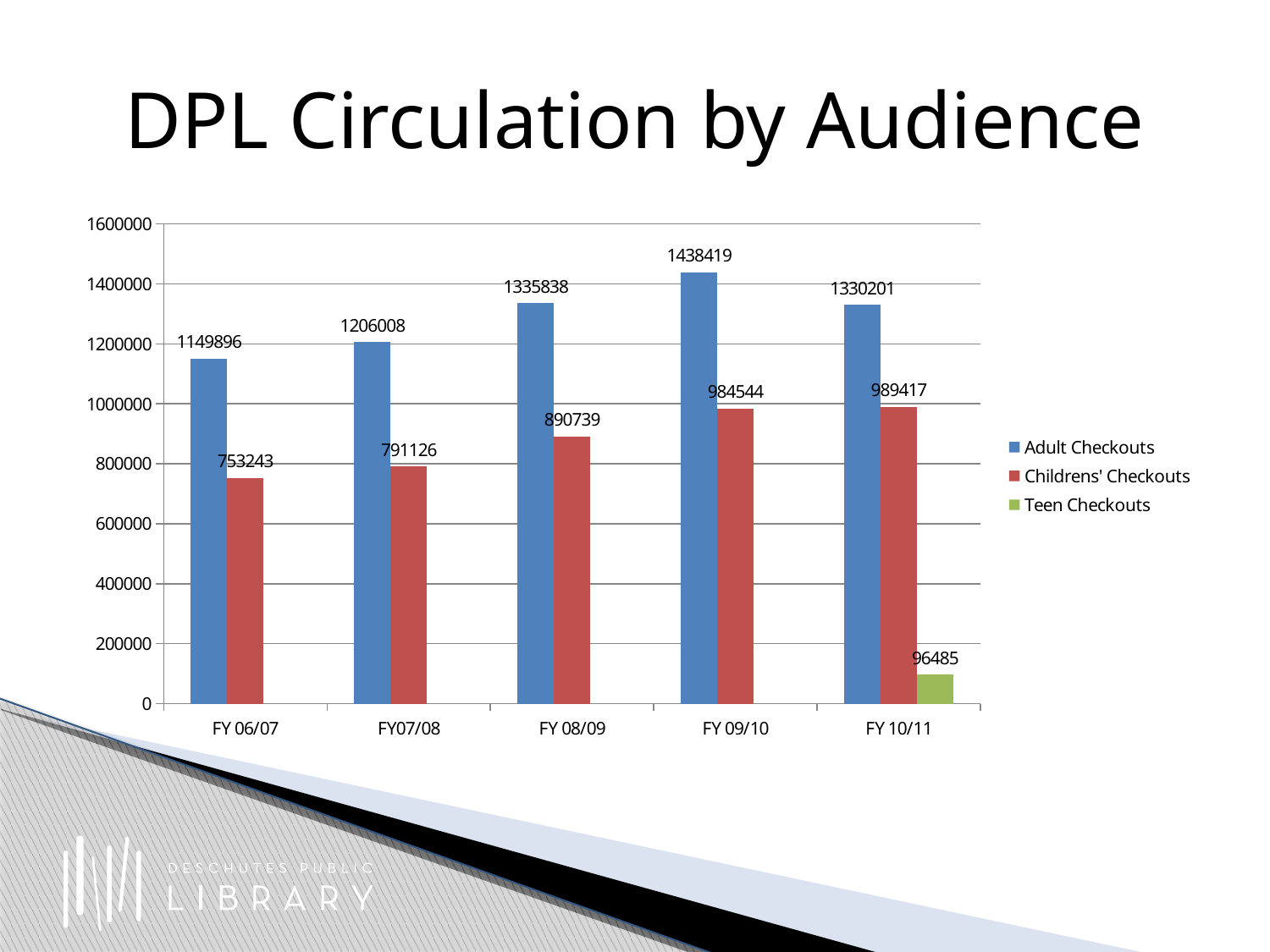
In which fiscal year are Childrens' Checkouts lowest? FY 06/07 How many series does the legend list? 3 What kind of chart is shown on the slide? bar chart What is the value for Childrens' Checkouts in FY 06/07? 753243 Which is larger: Adult Checkouts in FY 08/09 or Adult Checkouts in FY 10/11? Adult Checkouts in FY 08/09 In which fiscal year are Adult Checkouts highest? FY 09/10 What is the difference between Adult Checkouts and Childrens' Checkouts in FY 09/10? 453875 Is the value for Childrens' Checkouts in FY 10/11 greater or less than 1000000? less What is the value for Adult Checkouts in FY 09/10? 1438419 How many fiscal years are shown on the x axis? 5 What is the value for Teen Checkouts in FY 10/11? 96485 Do Childrens' Checkouts rise or fall from FY 06/07 to FY 10/11? rise